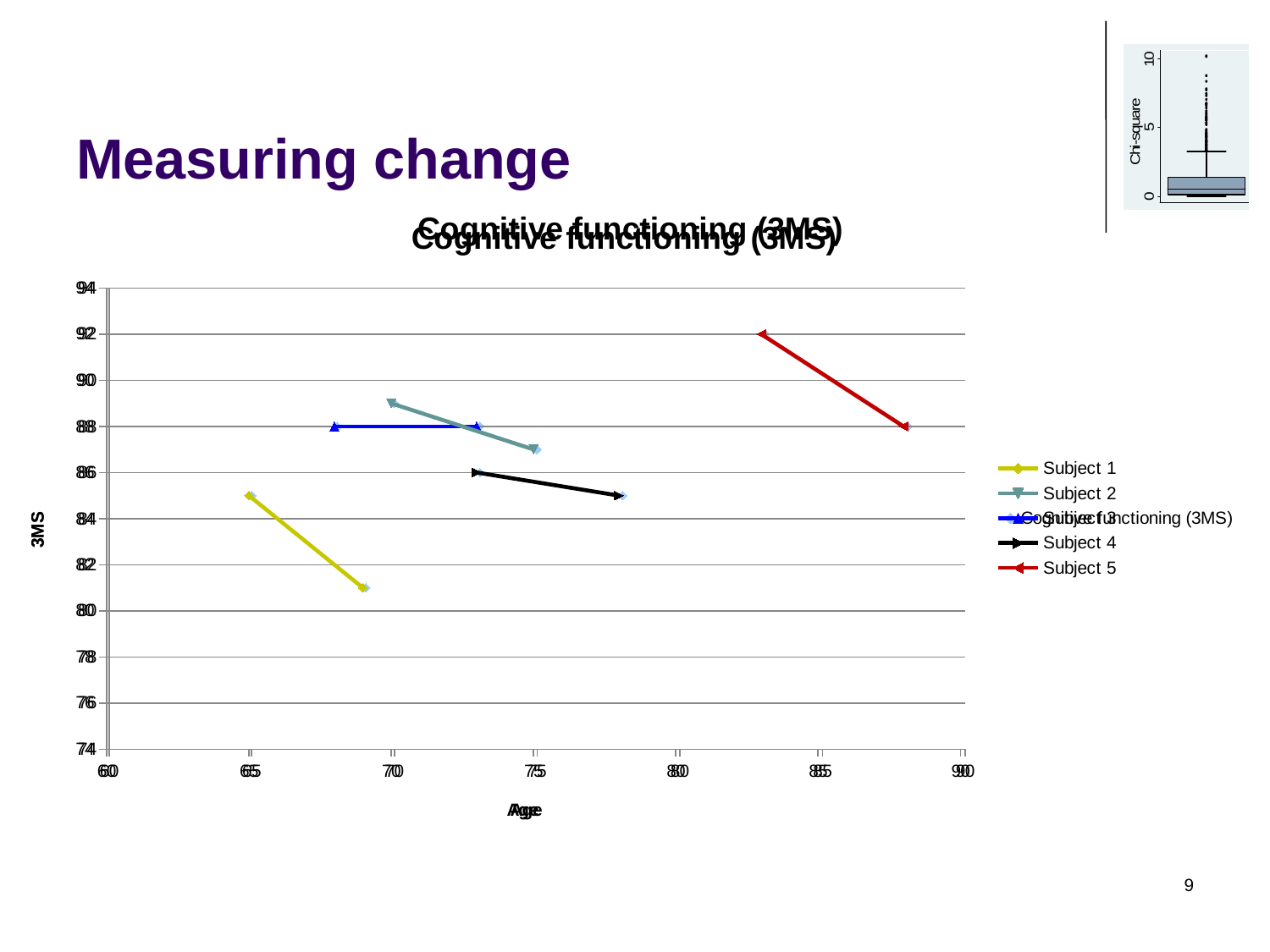
What is the highest 3MS value reached by Subject 5? 92 Does Subject 1's 3MS score rise or fall as age increases? fall Does Subject 5's 3MS score rise or fall as age increases? fall Is the final 3MS value for Subject 1 greater or less than 84? less Which subject has the lowest 3MS value in the main chart? Subject 1 What is the label of the x axis of the main chart? Age Is the starting 3MS value for Subject 5 greater or less than 90? greater What is the title of the main chart? Cognitive functioning (3MS) How many subjects are plotted as lines in the main chart? 5 At what 3MS value does Subject 3's line stay flat? 88 Which subject reaches the highest 3MS value in the main chart? Subject 5 What kind of chart is shown on the slide under the heading 'Measuring change'? line chart